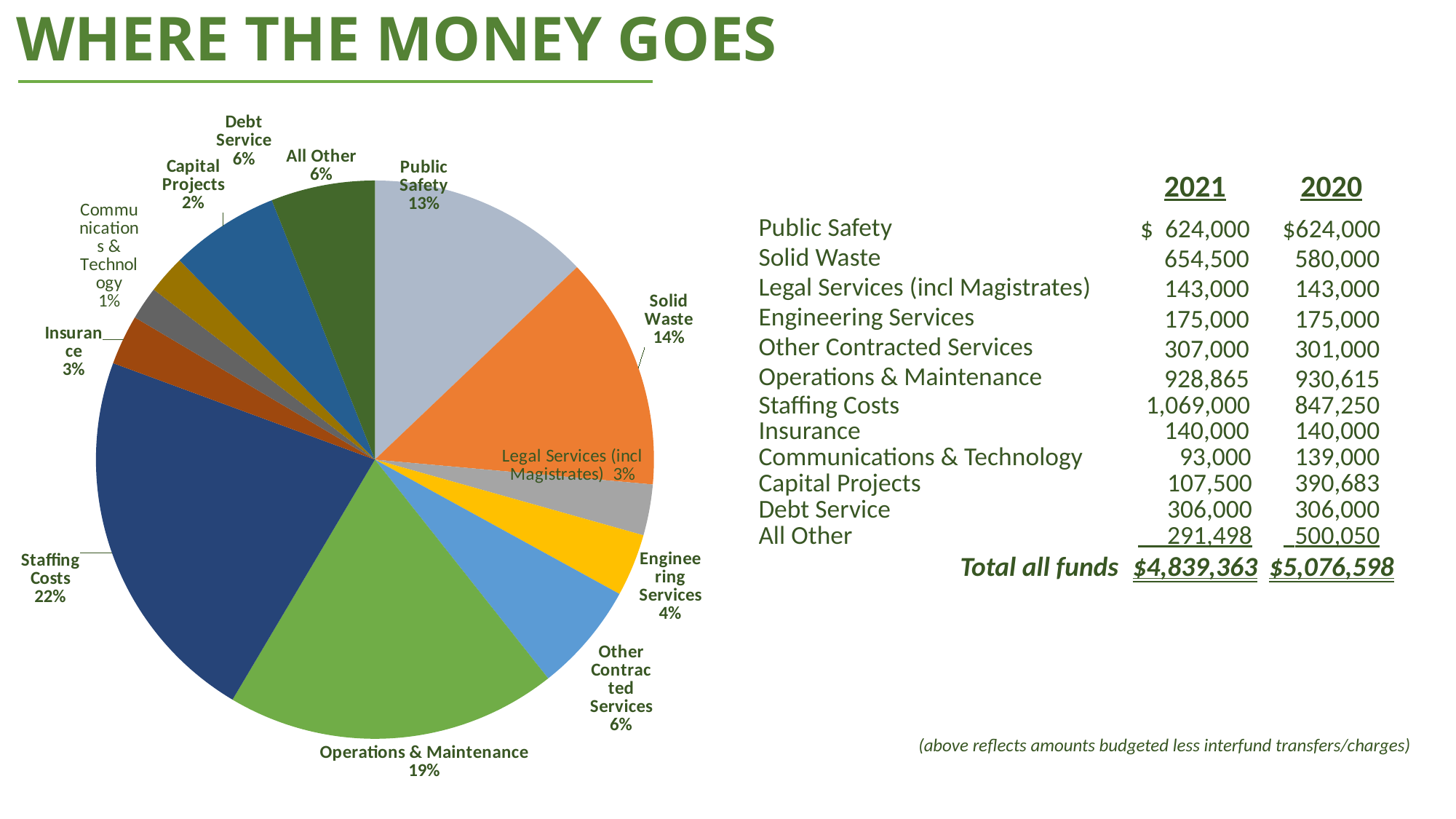
Which category has the largest slice in the pie chart? Staffing Costs What share of the pie chart is Staffing Costs? 22% What share of the pie chart is Operations & Maintenance? 19% What percentage is shown for Engineering Services in the pie chart? 4% Which category has the smallest slice in the pie chart? Communications & Technology Which slice is larger in the pie chart, Solid Waste or Public Safety? Solid Waste How many slices does the pie chart have? 12 What kind of chart is shown on the slide? pie chart What is the title of the slide containing the pie chart? WHERE THE MONEY GOES By how many percentage points does Staffing Costs exceed Operations & Maintenance in the pie chart? 3 What percentage is shown for Solid Waste in the pie chart? 14% What percentage is shown for Public Safety in the pie chart? 13%